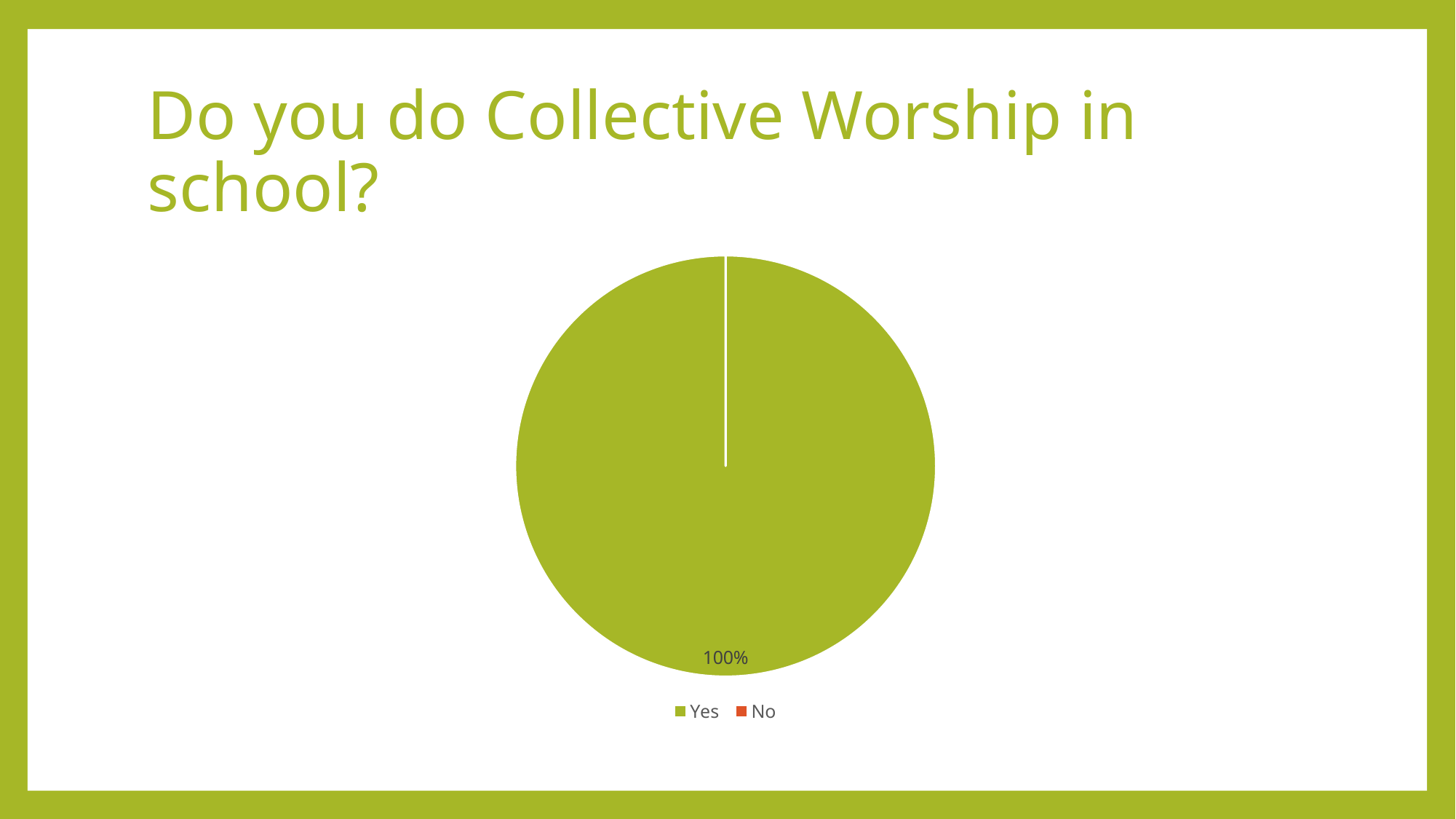
What share of the pie does the Yes slice take? 100% Is the share for Yes greater or less than 50%? greater What colour is the Yes slice in the legend? green Which is larger, the Yes slice or the No slice? Yes What is the title of the slide above the chart? Do you do Collective Worship in school? What kind of chart is shown on the slide? pie chart Which category has the smallest slice of the pie? No How many entries does the legend list? 2 Which category has the largest slice of the pie? Yes